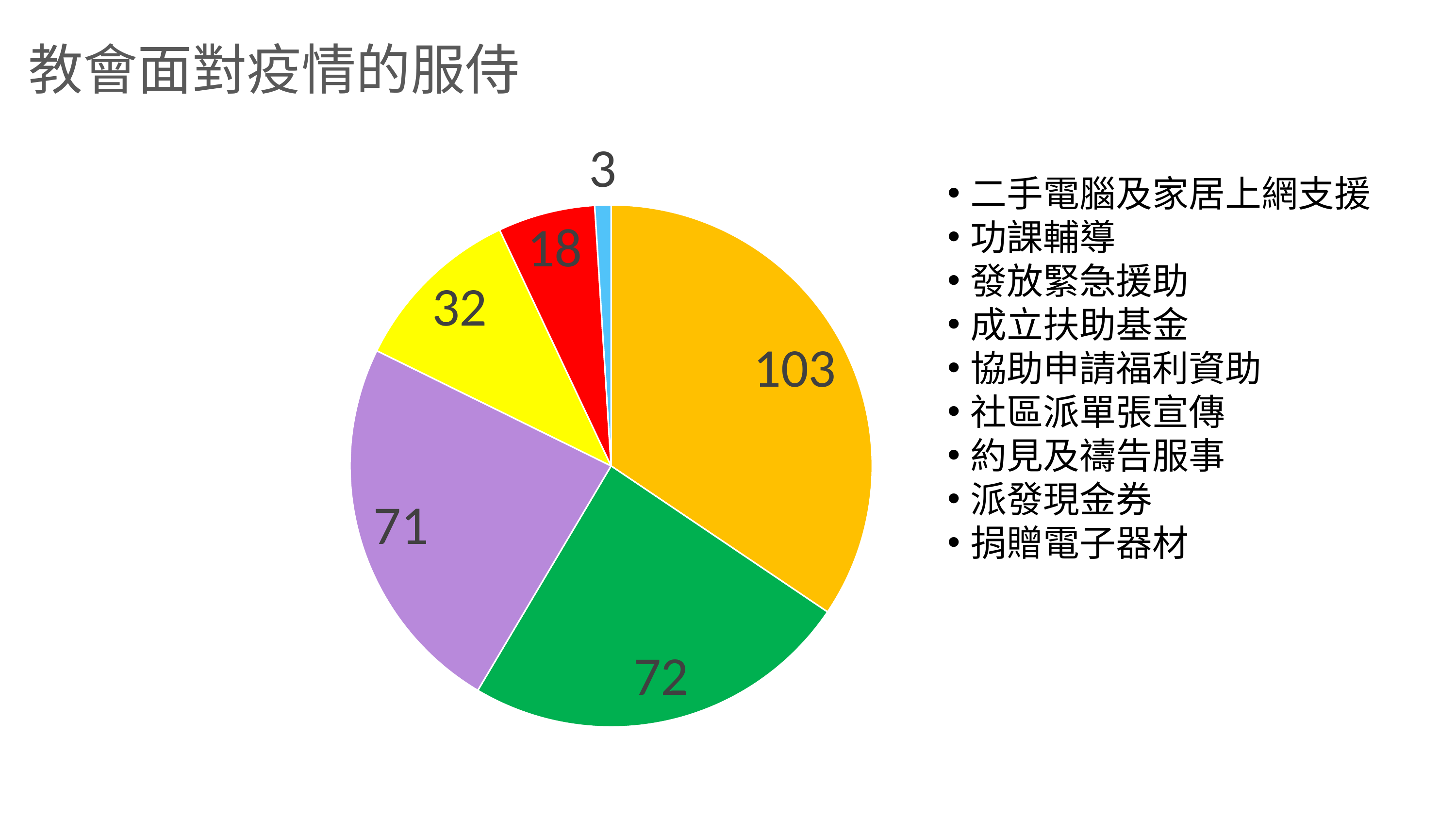
Which slice is larger, the yellow slice or the red slice? the yellow slice What is the difference between the orange slice (103) and the green slice (72)? 31 What is the value of the largest slice in the pie chart? 103 What value is shown on the green slice of the pie chart? 72 What value is shown on the orange slice of the pie chart? 103 What value is shown on the red slice of the pie chart? 18 What is the value of the smallest slice in the pie chart? 3 How many slices does the pie chart have? 6 What kind of chart is shown on the slide? pie chart What value is shown on the purple slice of the pie chart? 71 What value is shown on the yellow slice of the pie chart? 32 What is the title of the slide containing the pie chart? 教會面對疫情的服侍